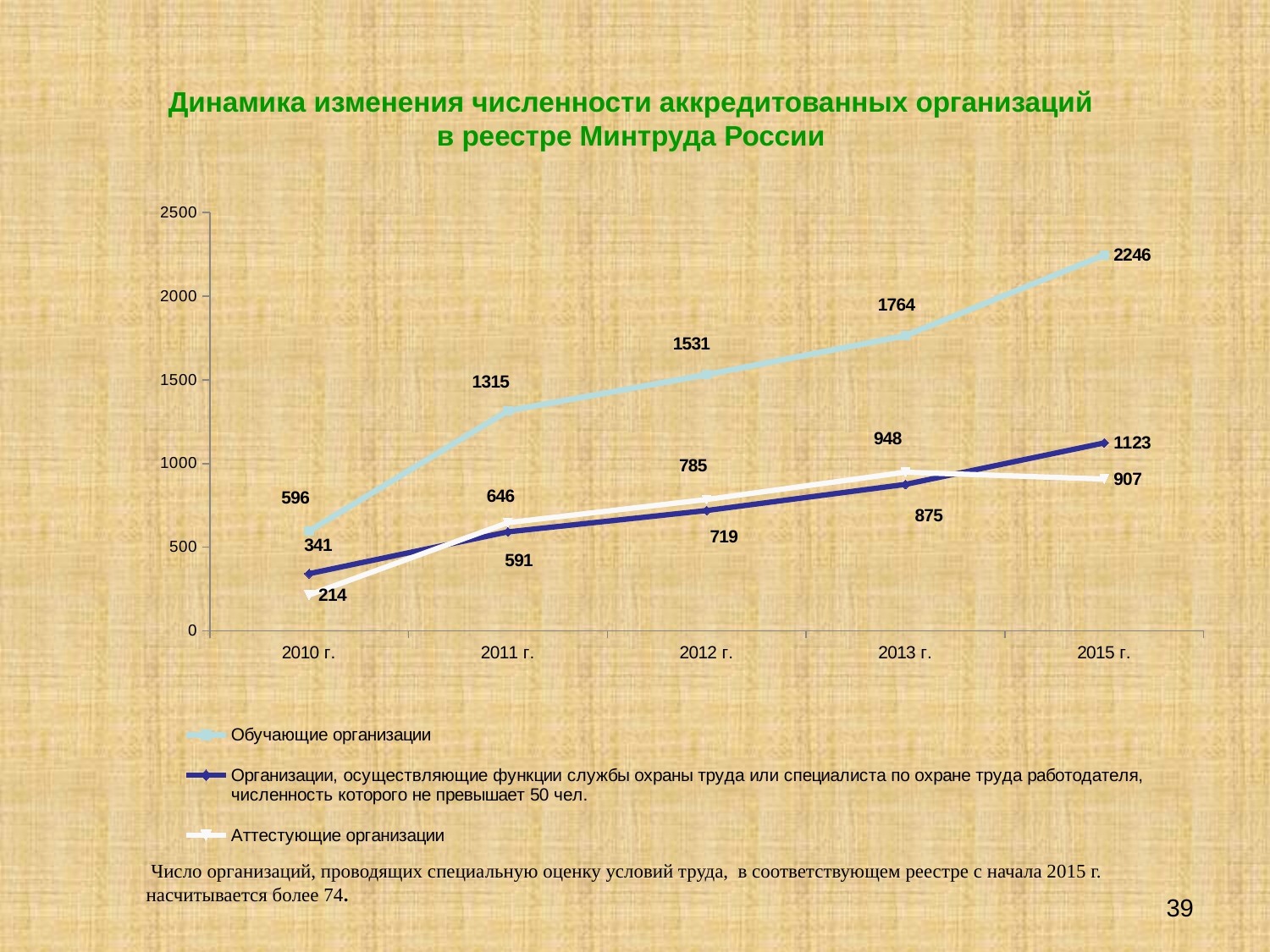
What is the value for Аттестующие организации in 2010 г.? 214 Does the value for Обучающие организации rise or fall from 2010 г. to 2015 г.? rise What is the value for Организации, осуществляющие функции службы охраны труда in 2012 г.? 719 In which year is the value for Аттестующие организации highest? 2013 г. Which is larger in 2015 г.: Организации, осуществляющие функции службы охраны труда or Аттестующие организации? Организации, осуществляющие функции службы охраны труда What is the difference between the Обучающие организации values in 2015 г. and 2013 г.? 482 How many years are shown on the x axis? 5 What type of chart is shown on the slide? line chart How many series does the legend list? 3 What is the value for Обучающие организации in 2015 г.? 2246 In which year is the value for Обучающие организации lowest? 2010 г. What is the title of the chart? Динамика изменения численности аккредитованных организаций в реестре Минтруда России